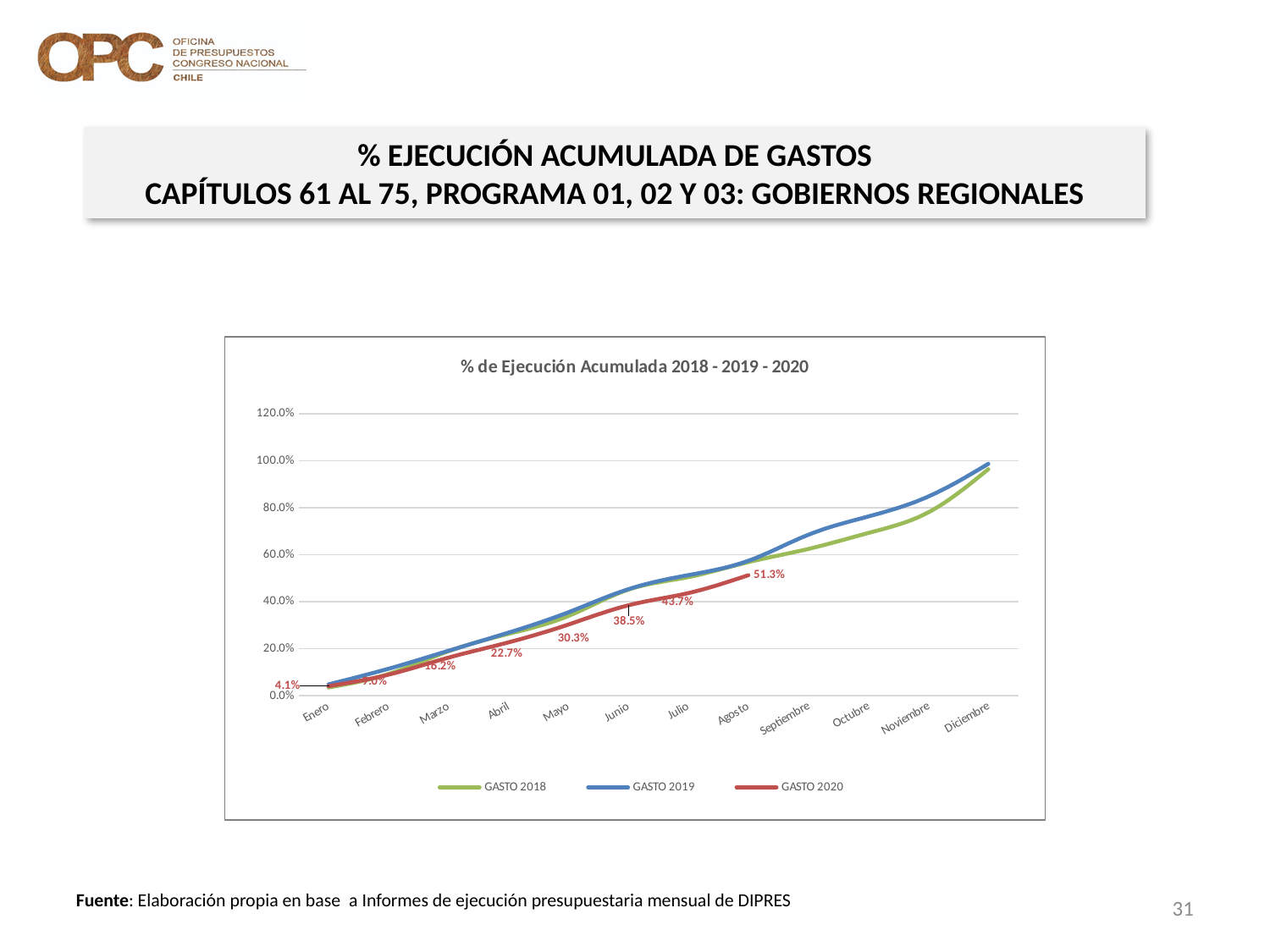
Do the GASTO 2020 values rise or fall from Enero to Agosto? rise What is the value for GASTO 2020 in Enero? 4.1% What kind of chart is shown on the slide? line chart What is the difference between the GASTO 2020 values for Agosto and Julio? 7.6% What is the value for GASTO 2020 in Marzo? 16.2% How many series does the legend list? 3 What is the title of the chart? % de Ejecución Acumulada 2018 - 2019 - 2020 Is the value for GASTO 2019 in Diciembre greater or less than 80%? greater What is the value for GASTO 2020 in Agosto? 51.3% What is the value for GASTO 2020 in Mayo? 30.3% How many months are shown along the x axis? 12 In Octubre, which series has the higher value, GASTO 2019 or GASTO 2018? GASTO 2019